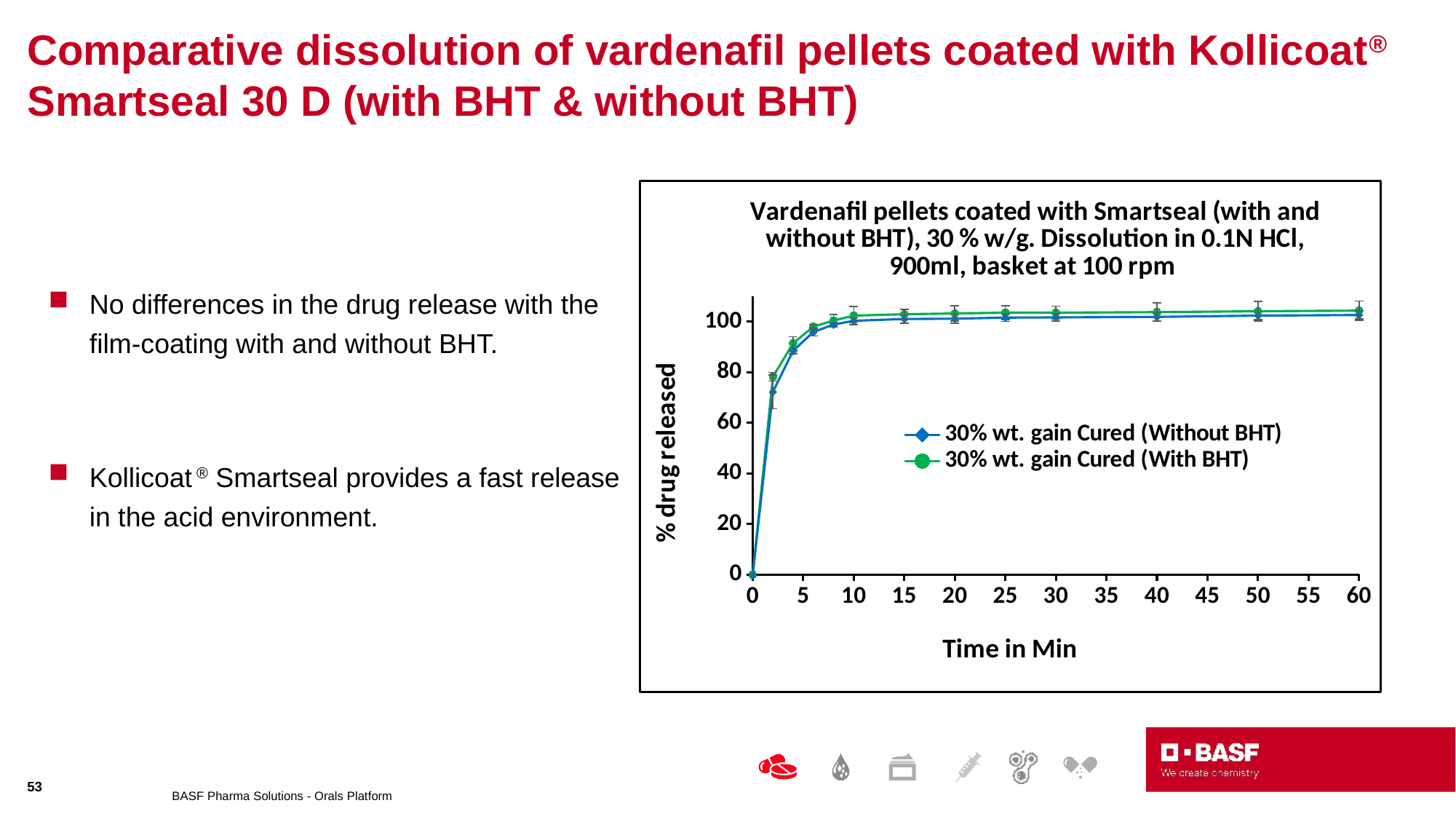
What is the % drug released for the 30% wt. gain Cured (With BHT) series at time 0? 0 What are the two series named in the chart legend? 30% wt. gain Cured (Without BHT) and 30% wt. gain Cured (With BHT) Is the value for 30% wt. gain Cured (With BHT) at 60 minutes greater or less than 80? greater How does the % drug released change as time increases from 0 to 60 minutes? rises sharply then levels off How many series does the chart legend list? 2 What kind of chart is shown on the slide? line chart What is the highest value shown on the x axis (Time in Min)? 60 Is the value for 30% wt. gain Cured (Without BHT) at 2 minutes greater or less than 100? less What is the label of the y axis of the chart? % drug released Is the value for 30% wt. gain Cured (Without BHT) at 10 minutes greater or less than 80? greater